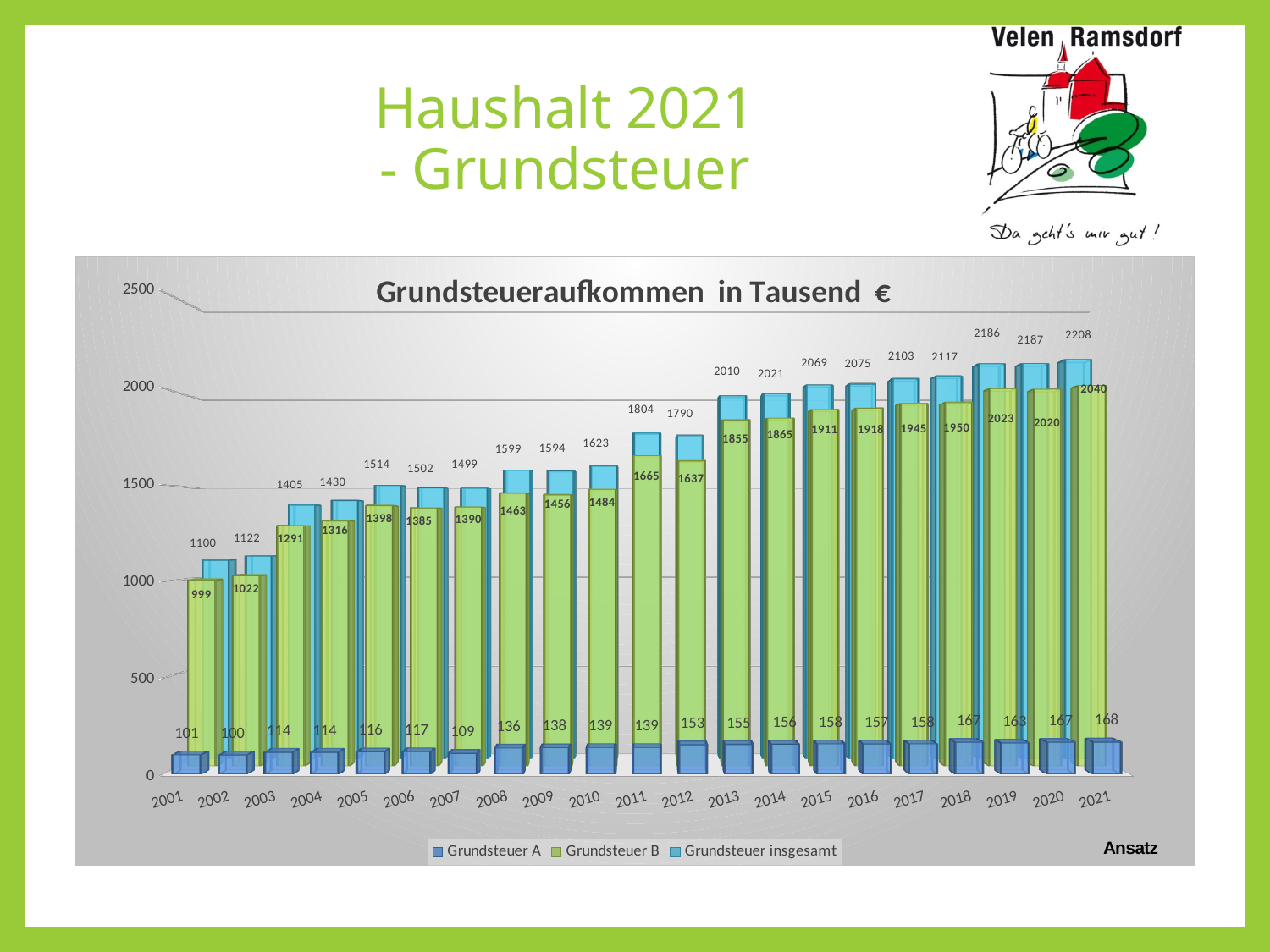
Does Grundsteuer insgesamt generally rise or fall from 2001 to 2021? rise By how much did Grundsteuer insgesamt increase from 2001 to 2021? 1108 What is the value of Grundsteuer B for 2013? 1855 What kind of chart is shown on the slide? bar chart What is the title of the chart? Grundsteueraufkommen in Tausend € What is the value of Grundsteuer A for 2001? 101 How many years are shown on the x axis? 21 What is the value of Grundsteuer insgesamt for 2021? 2208 Which year has the larger Grundsteuer B value, 2011 or 2012? 2011 In which year is Grundsteuer insgesamt highest? 2021 In which year is Grundsteuer A lowest? 2002 How many series does the legend list? 3